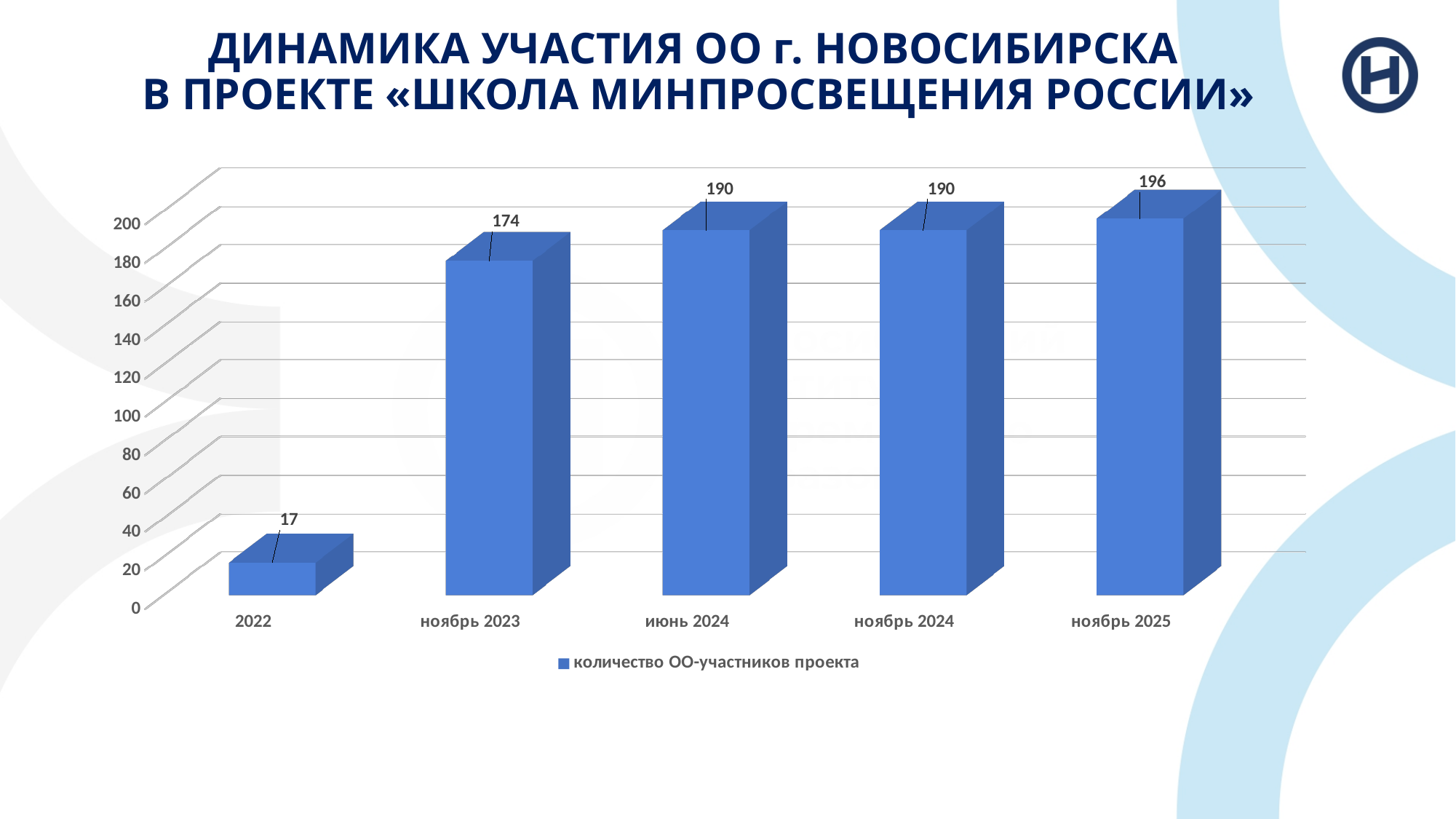
What kind of chart is shown on the slide? bar chart What is the difference between the values for ноябрь 2025 and июнь 2024? 6 What is the value for ноябрь 2023? 174 What is the legend entry for the series? количество ОО-участников проекта Which category has the lowest value? 2022 What is the value for ноябрь 2025? 196 How many series does the legend list? 1 Which category has the highest value? ноябрь 2025 How many categories are shown on the x axis? 5 Which is larger, the value for ноябрь 2023 or the value for ноябрь 2024? ноябрь 2024 What is the difference between the values for ноябрь 2023 and 2022? 157 What is the value for 2022? 17